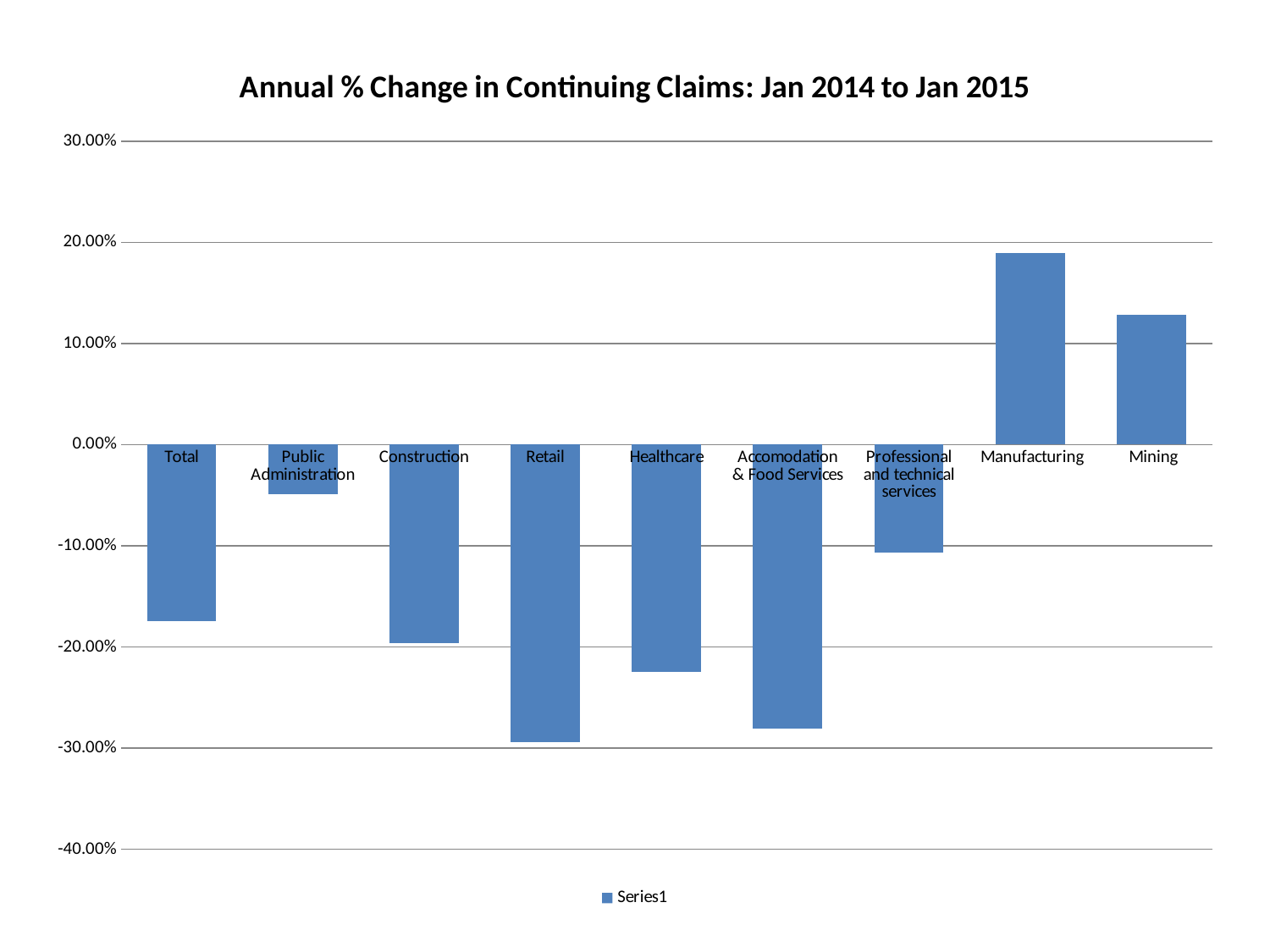
What kind of chart is shown on the slide? bar chart Which is larger, the value for Manufacturing or the value for Mining? Manufacturing How many categories have a positive annual % change? 2 What is the title of the chart? Annual % Change in Continuing Claims: Jan 2014 to Jan 2015 How many categories are plotted on the chart? 9 Is the value for Total greater or less than -10.00%? less How many series does the legend list? 1 Is the value for Manufacturing greater or less than 10.00%? greater Is the value for Healthcare greater or less than -20.00%? less Which category has the highest annual % change in continuing claims? Manufacturing Which category has the lowest annual % change in continuing claims? Retail